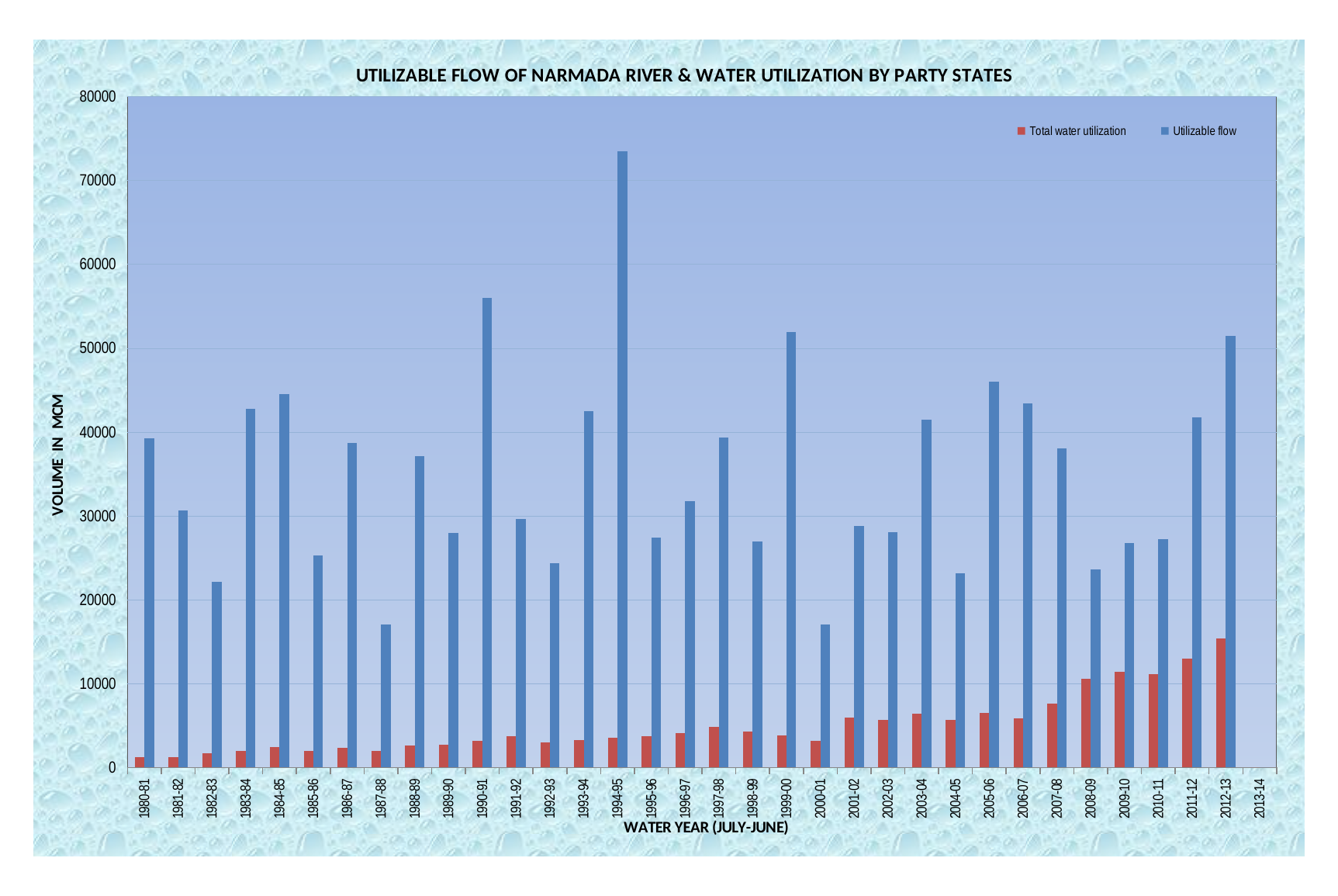
Does the Total water utilization generally rise or fall from 1980-81 to 2012-13? Rise How many series does the legend list? 2 Is the Utilizable flow for 1982-83 greater or less than 30000? less Which is larger, the Total water utilization for 2011-12 or for 2008-09? 2011-12 Which is larger, the Utilizable flow for 1994-95 or for 1990-91? 1994-95 Is the Utilizable flow for 1990-91 greater or less than 50000? greater Is the Utilizable flow for 1994-95 greater or less than 70000? greater What kind of chart is shown on the slide? Bar chart Which water year has the highest Total water utilization? 2012-13 Which water year has the highest Utilizable flow? 1994-95